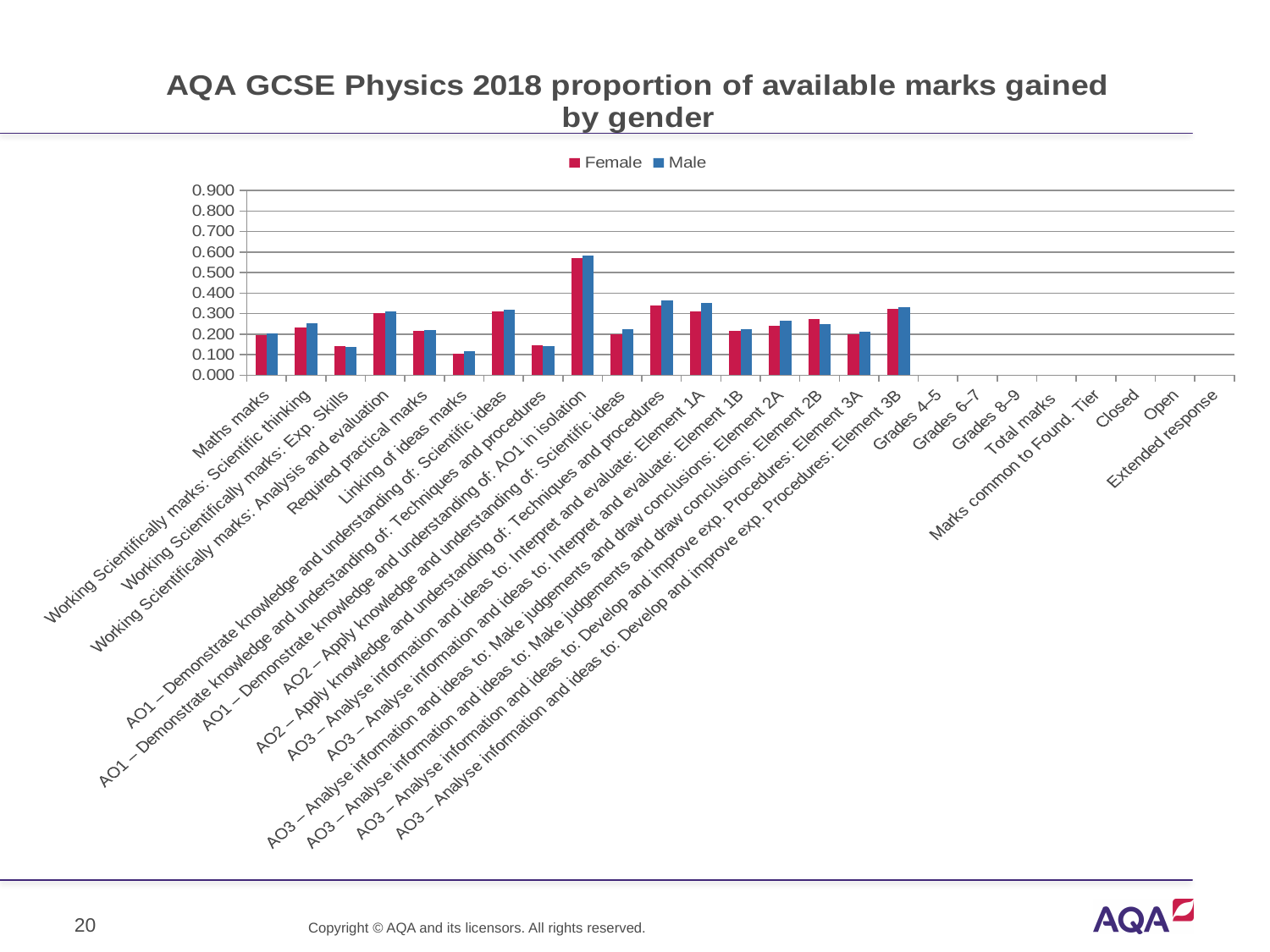
Is the Male value for AO1 – Demonstrate knowledge and understanding of: AO1 in isolation greater or less than 0.500? greater Which category has the highest value for the Female series? AO1 – Demonstrate knowledge and understanding of: AO1 in isolation What is the title of the chart? AQA GCSE Physics 2018 proportion of available marks gained by gender What kind of chart is shown on the slide? bar chart For AO3 – Analyse information and ideas to: Interpret and evaluate: Element 1A, which series has the larger value, Female or Male? Male Is the Male value for AO3 – Analyse information and ideas to: Interpret and evaluate: Element 1A greater or less than 0.300? greater Which two series are shown in the legend? Female and Male How many category labels are shown on the x axis? 25 How many series does the legend list? 2 Among the categories with plotted bars, which has the lowest Female value? Linking of ideas marks Is the Female value for Working Scientifically marks: Exp. Skills greater or less than 0.200? less Which category has the highest value for the Male series? AO1 – Demonstrate knowledge and understanding of: AO1 in isolation